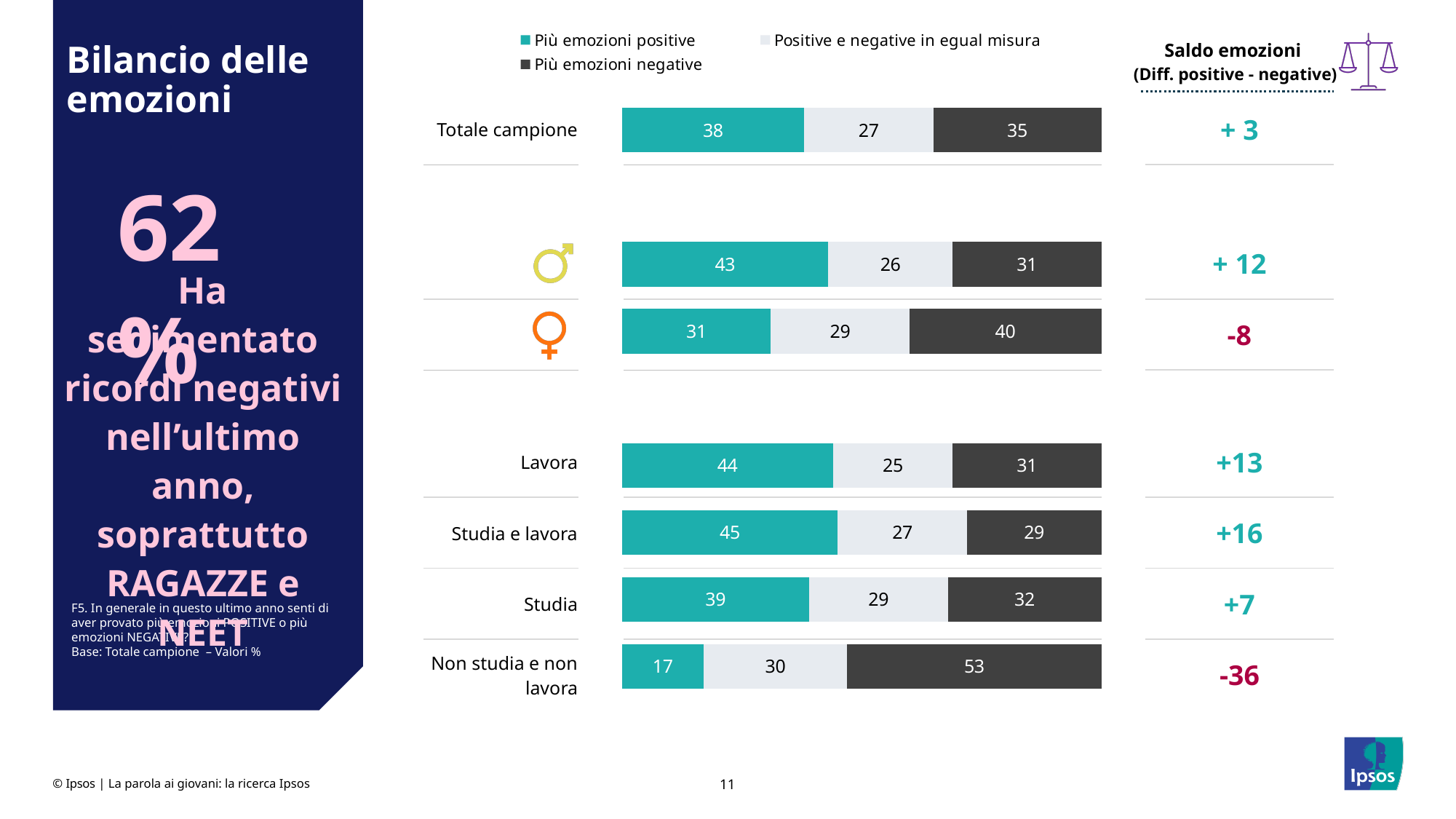
What is the value of "Positive e negative in egual misura" for "Studia"? 29 What is the value of "Più emozioni positive" for "Totale campione"? 38 What is the value of "Più emozioni negative" for "Non studia e non lavora"? 53 Which category has the lowest value for "Più emozioni positive"? Non studia e non lavora What kind of chart is shown on the slide? stacked bar chart What is the total of the stacked bar for "Lavora"? 100 How many series does the legend list? 3 What is the difference between the "Più emozioni negative" values for "Non studia e non lavora" and "Lavora"? 22 Which is larger: the "Più emozioni positive" value for "Lavora" or for "Studia"? Lavora What is the "Saldo emozioni" value shown for "Non studia e non lavora"? -36 Which category has the highest value for "Più emozioni positive"? Studia e lavora What is the "Saldo emozioni" value shown for "Studia e lavora"? +16